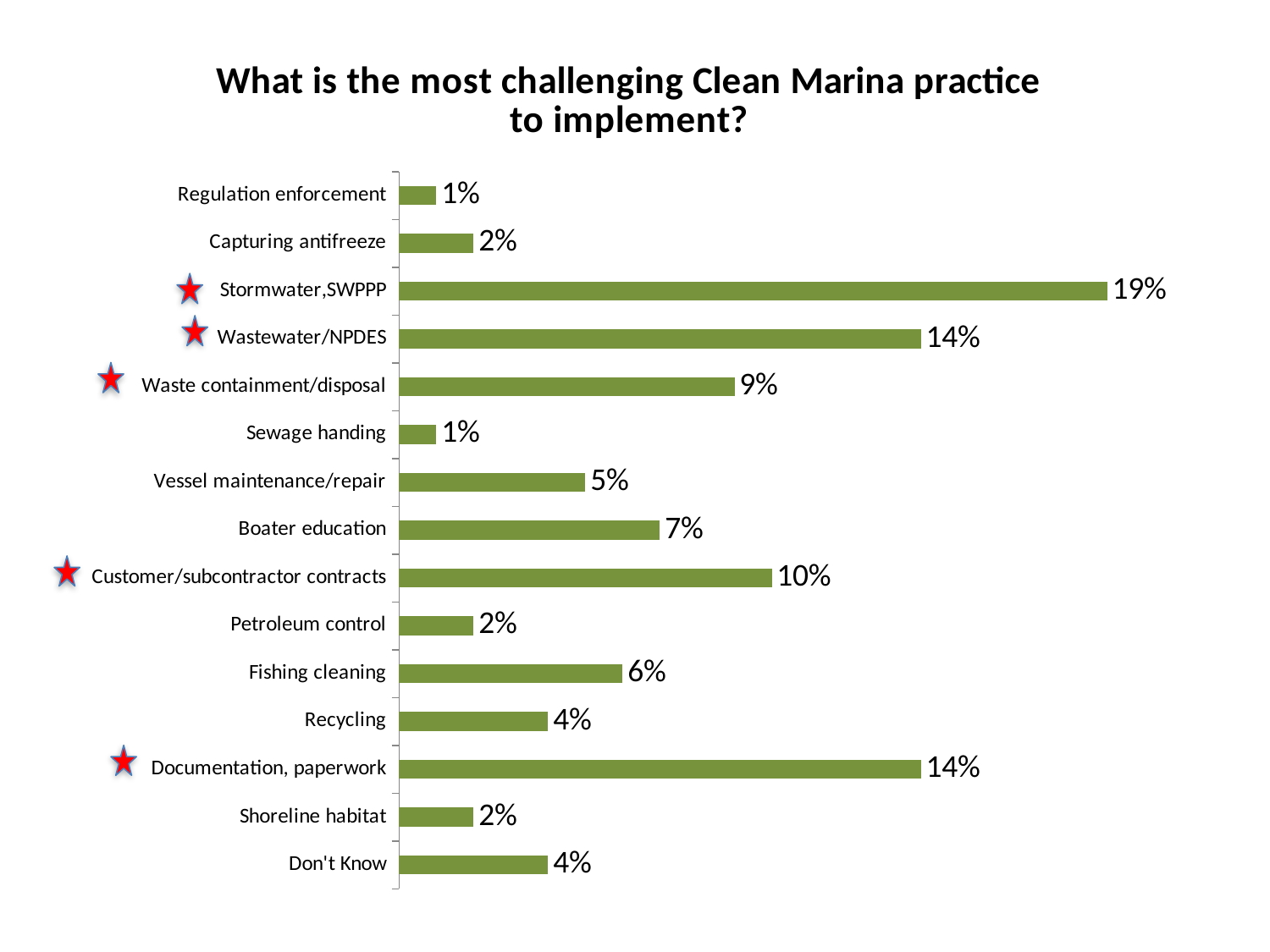
Which category has the highest value? Stormwater,SWPPP What percentage is shown for Boater education? 7% What is the difference between the values for Stormwater,SWPPP and Wastewater/NPDES? 5% What percentage is shown for Fishing cleaning? 6% What is the difference between the values for Waste containment/disposal and Vessel maintenance/repair? 4% What kind of chart is shown on the slide? Bar chart How many categories are shown in the chart? 15 Which is larger, the value for Recycling or the value for Fishing cleaning? Fishing cleaning Which is larger, the value for Documentation, paperwork or the value for Customer/subcontractor contracts? Documentation, paperwork What percentage is shown for Customer/subcontractor contracts? 10% What is the title of the chart? What is the most challenging Clean Marina practice to implement? What percentage is shown for Stormwater,SWPPP? 19%